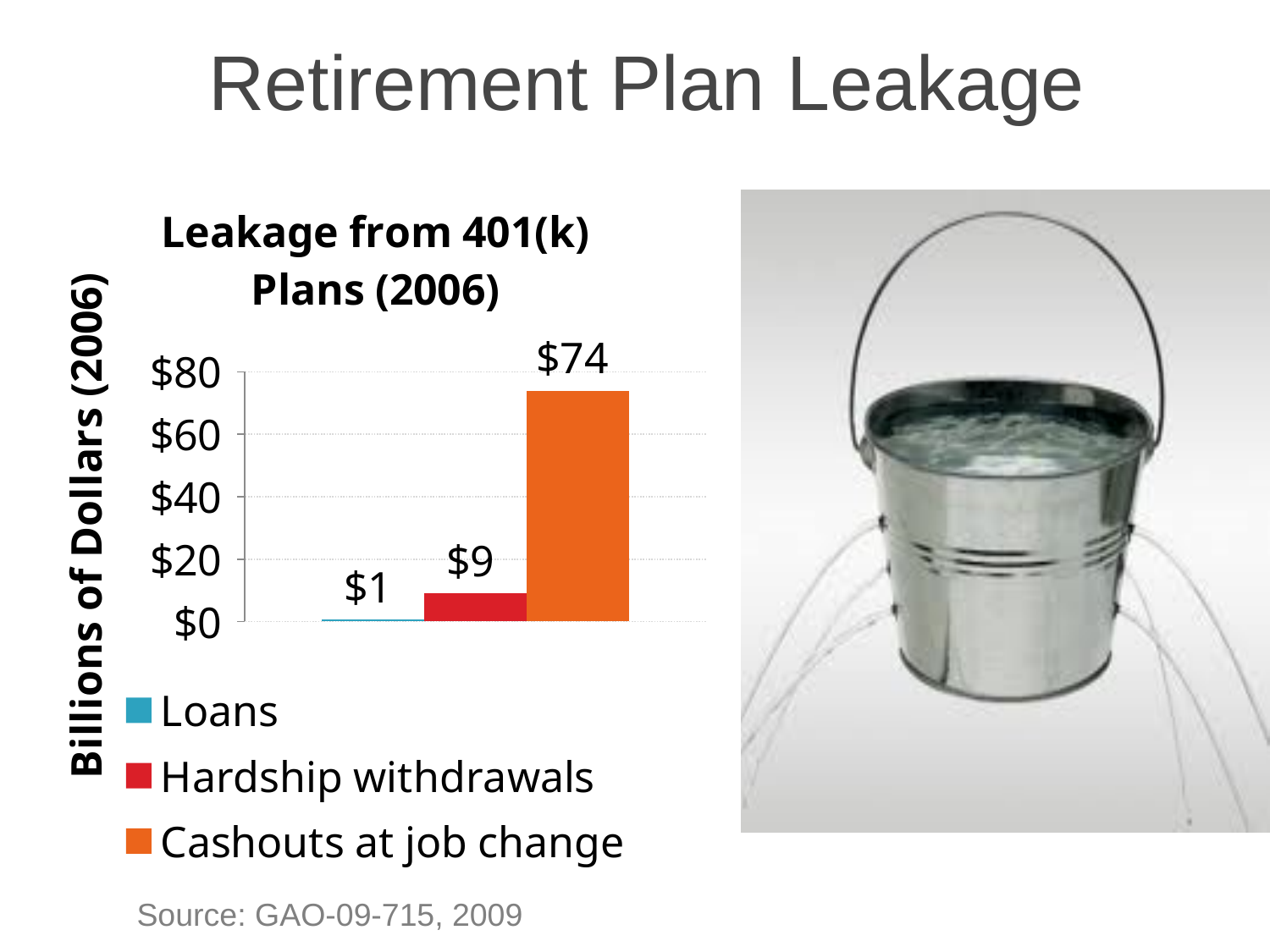
Is the value for Cashouts at job change greater or less than $60? greater What is the value for Cashouts at job change? $74 What is the difference between Hardship withdrawals and Loans? $8 What is the difference between Cashouts at job change and Hardship withdrawals? $65 What kind of chart is shown? bar chart Which series has the lowest value? Loans What is the value for Hardship withdrawals? $9 Which series has the highest value? Cashouts at job change What is the title of the chart? Leakage from 401(k) Plans (2006) What is the value for Loans? $1 How many series does the legend list? 3 Which is larger, Hardship withdrawals or Loans? Hardship withdrawals